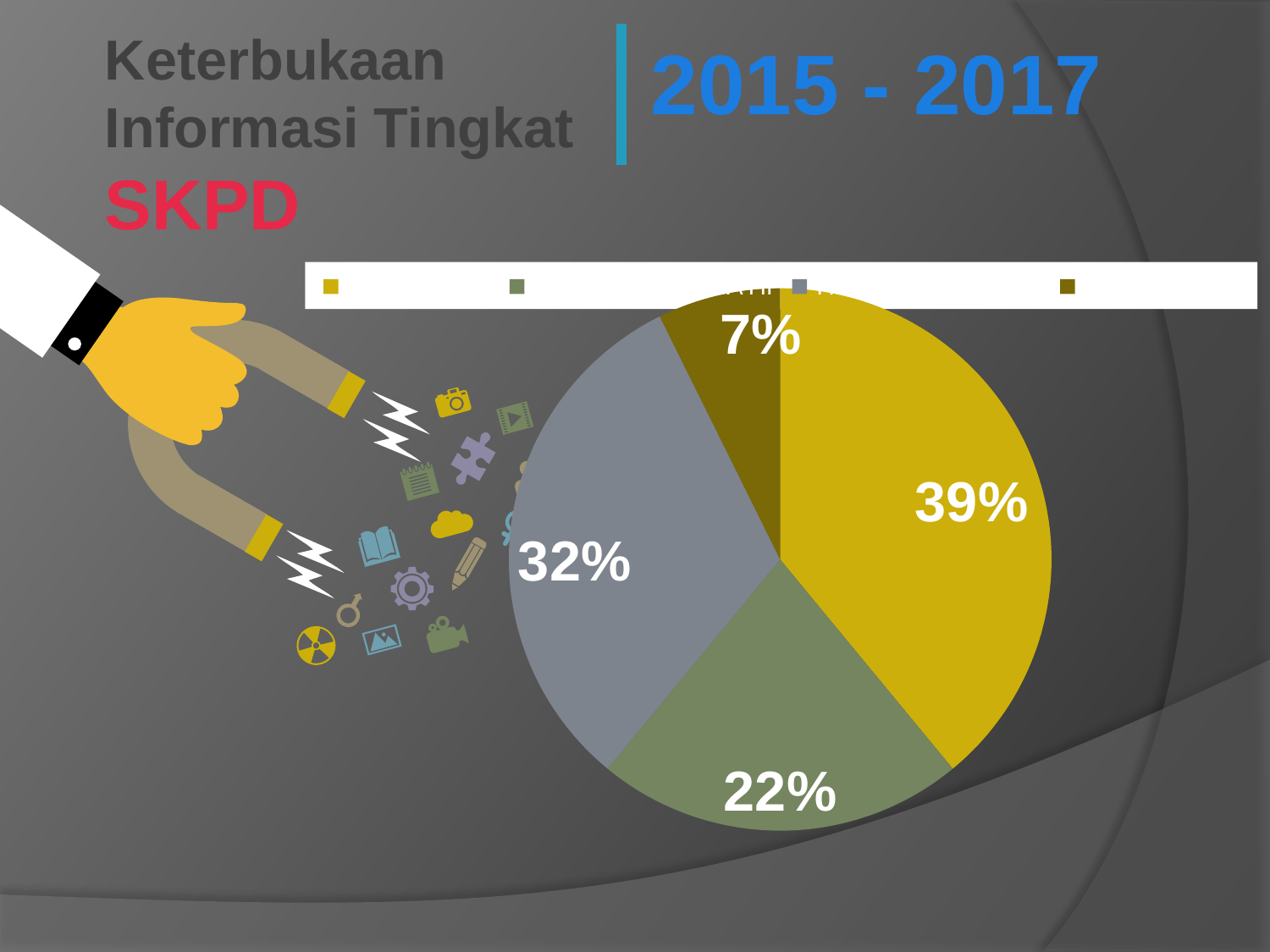
What percentage is shown on the yellow slice of the pie chart? 39% What is the difference in percentage points between the largest slice (39%) and the smallest slice (7%)? 32 What is the largest percentage shown on the pie chart? 39% What is the smallest percentage shown on the pie chart? 7% What kind of chart is shown on the slide? pie chart How many entries does the legend of the pie chart list? 4 How many slices does the pie chart have? 4 What percentage is shown on the dark gold slice of the pie chart? 7% What period is shown in the slide title above the pie chart? 2015 - 2017 What percentage is shown on the green slice of the pie chart? 22% What percentage is shown on the grey slice of the pie chart? 32% Which slice is larger, the grey slice or the green slice? the grey slice (32%)